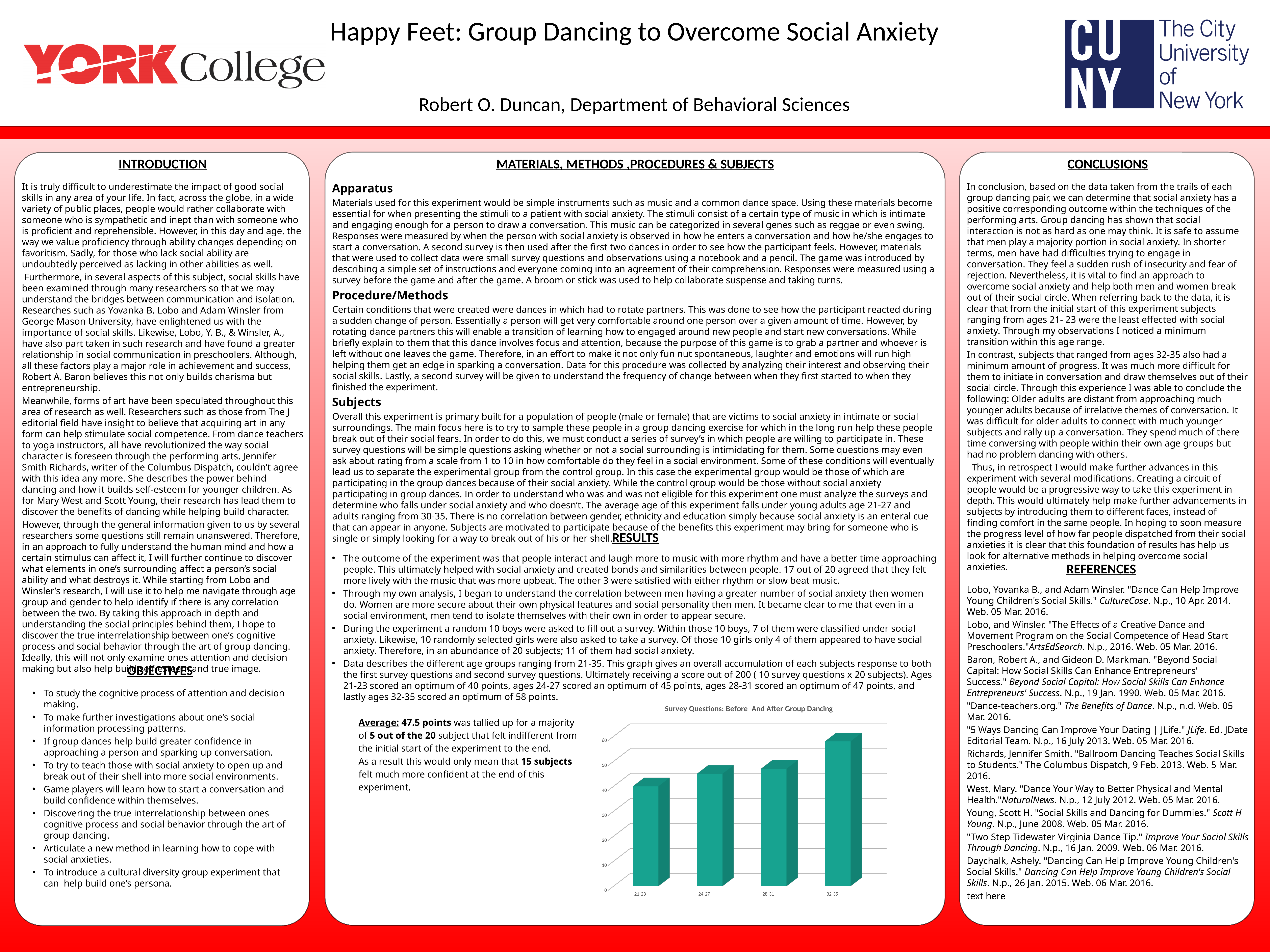
Is the value for the 32-35 age group greater or less than 50? greater What is the title of the chart? Survey Questions: Before And After Group Dancing Which is larger, the value for the 32-35 age group or the value for the 21-23 age group? 32-35 How many age-group categories are plotted on the chart? 4 Is the value for the 24-27 age group greater or less than 50? less Is the value for the 28-31 age group greater or less than 40? greater Which age group has the highest bar on the chart? 32-35 Do the bar values rise or fall as the age groups move from 21-23 to 32-35 along the x axis? rise What kind of chart is shown on the slide? bar chart What is the highest value labelled on the chart's vertical axis? 60 Which age group has the lowest bar on the chart? 21-23